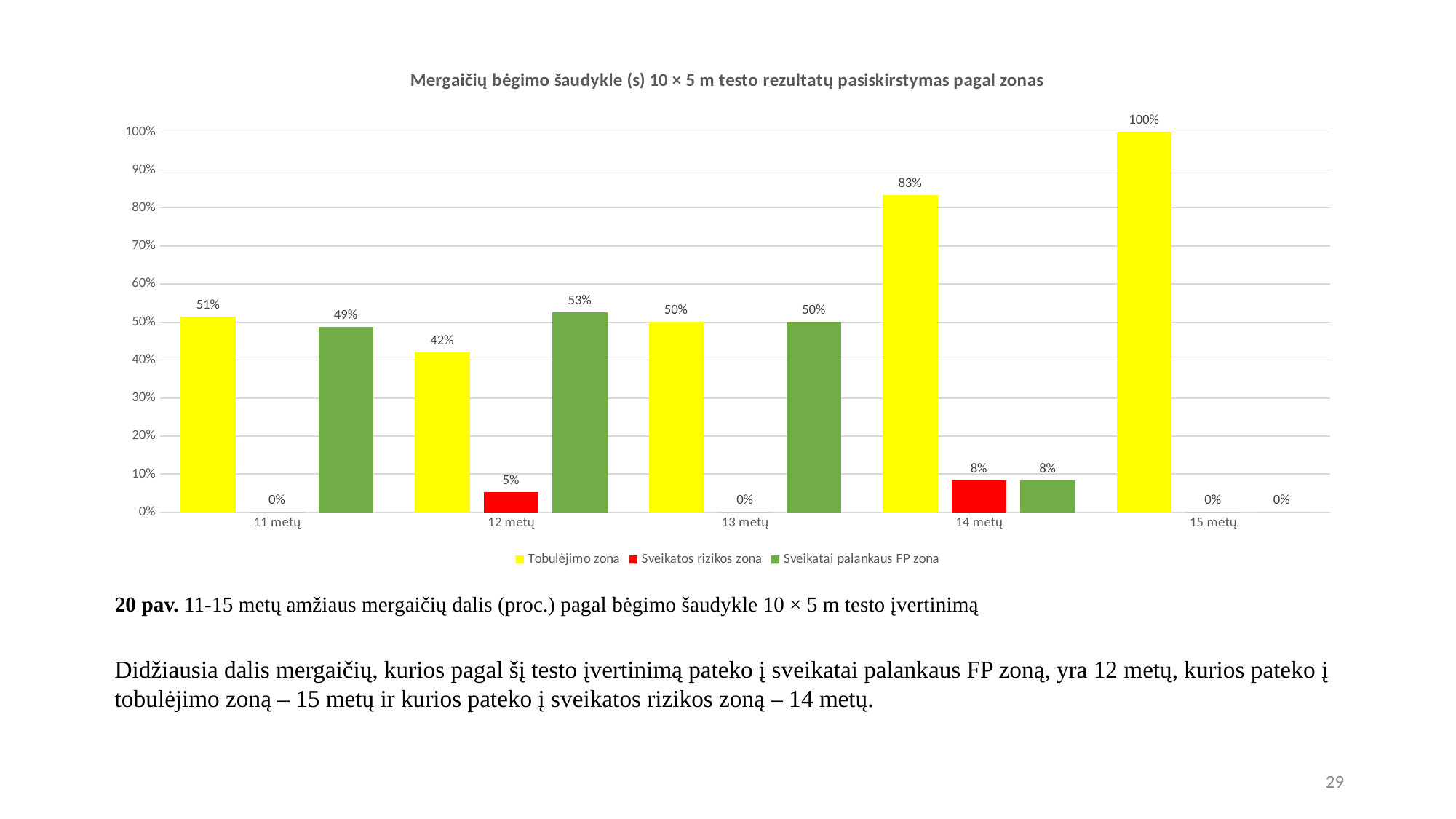
Which colour represents Sveikatos rizikos zona in the legend? Red What kind of chart is shown on the slide? Bar chart How many age groups are shown on the x axis? 5 Which age group has the highest value for Tobulėjimo zona? 15 metų What is the value of Sveikatai palankaus FP zona for 12 metų? 53% What is the value of Sveikatos rizikos zona for 14 metų? 8% What is the value of Sveikatos rizikos zona for 15 metų? 0% What is the difference between Tobulėjimo zona for 14 metų and Tobulėjimo zona for 11 metų? 32% How many series does the legend list? 3 Which is larger for 12 metų: Tobulėjimo zona or Sveikatai palankaus FP zona? Sveikatai palankaus FP zona What is the value of Tobulėjimo zona for 11 metų? 51% Which age group has the lowest value for Tobulėjimo zona? 12 metų